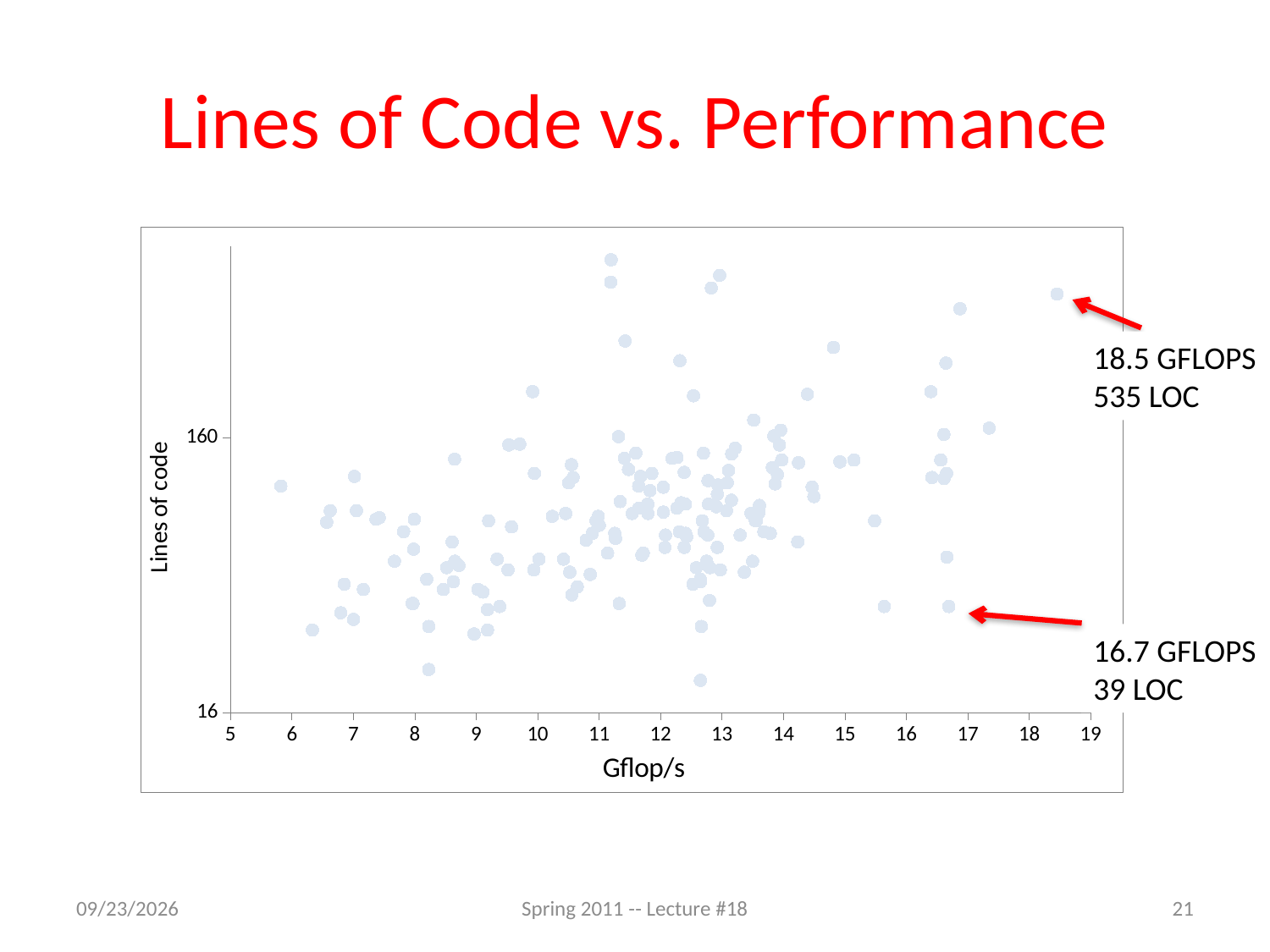
What is the performance in GFLOPS of the annotated point with 535 lines of code? 18.5 GFLOPS Is the lines-of-code value for the annotated point at 16.7 GFLOPS greater or less than 160? less What is the label of the x axis of the chart? Gflop/s What is the difference in lines of code between the two annotated points (535 LOC and 39 LOC)? 496 What is the highest Gflop/s value among the plotted points, as annotated on the chart? 18.5 GFLOPS Which annotated point has more lines of code, the one at 18.5 GFLOPS or the one at 16.7 GFLOPS? the one at 18.5 GFLOPS What is the performance in GFLOPS of the annotated point with 39 lines of code? 16.7 GFLOPS What is the difference in GFLOPS between the two annotated points (18.5 and 16.7)? 1.8 How many lines of code does the annotated point at 16.7 GFLOPS have? 39 LOC What is the title of the chart on the slide? Lines of Code vs. Performance What kind of chart is shown on the slide? scatter plot How many lines of code does the annotated point at 18.5 GFLOPS have? 535 LOC